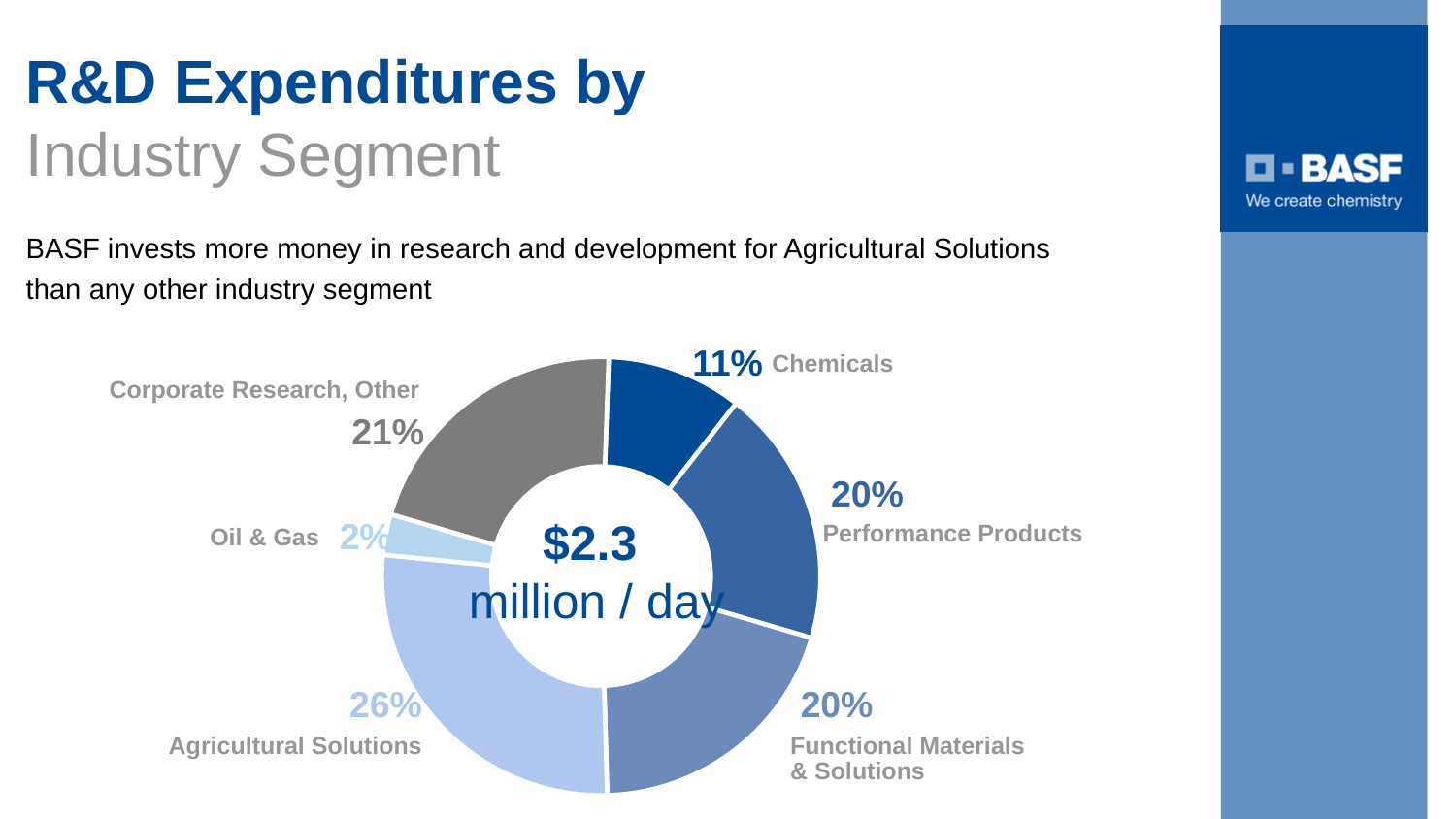
What share of R&D expenditures goes to Corporate Research, Other? 21% Which industry segment has the largest share of R&D expenditures? Agricultural Solutions What share of R&D expenditures goes to Oil & Gas? 2% Which two segments each have a 20% share? Performance Products and Functional Materials & Solutions What is the difference in percentage points between Agricultural Solutions and Chemicals? 15 percentage points What kind of chart is shown on the slide? Doughnut chart What share of R&D expenditures goes to Agricultural Solutions? 26% What share of R&D expenditures goes to Chemicals? 11% How many industry segments are shown in the chart? 6 Which industry segment has the smallest share of R&D expenditures? Oil & Gas What value is printed in the centre of the doughnut chart? $2.3 million / day Which has a larger share of R&D expenditures, Corporate Research, Other or Performance Products? Corporate Research, Other